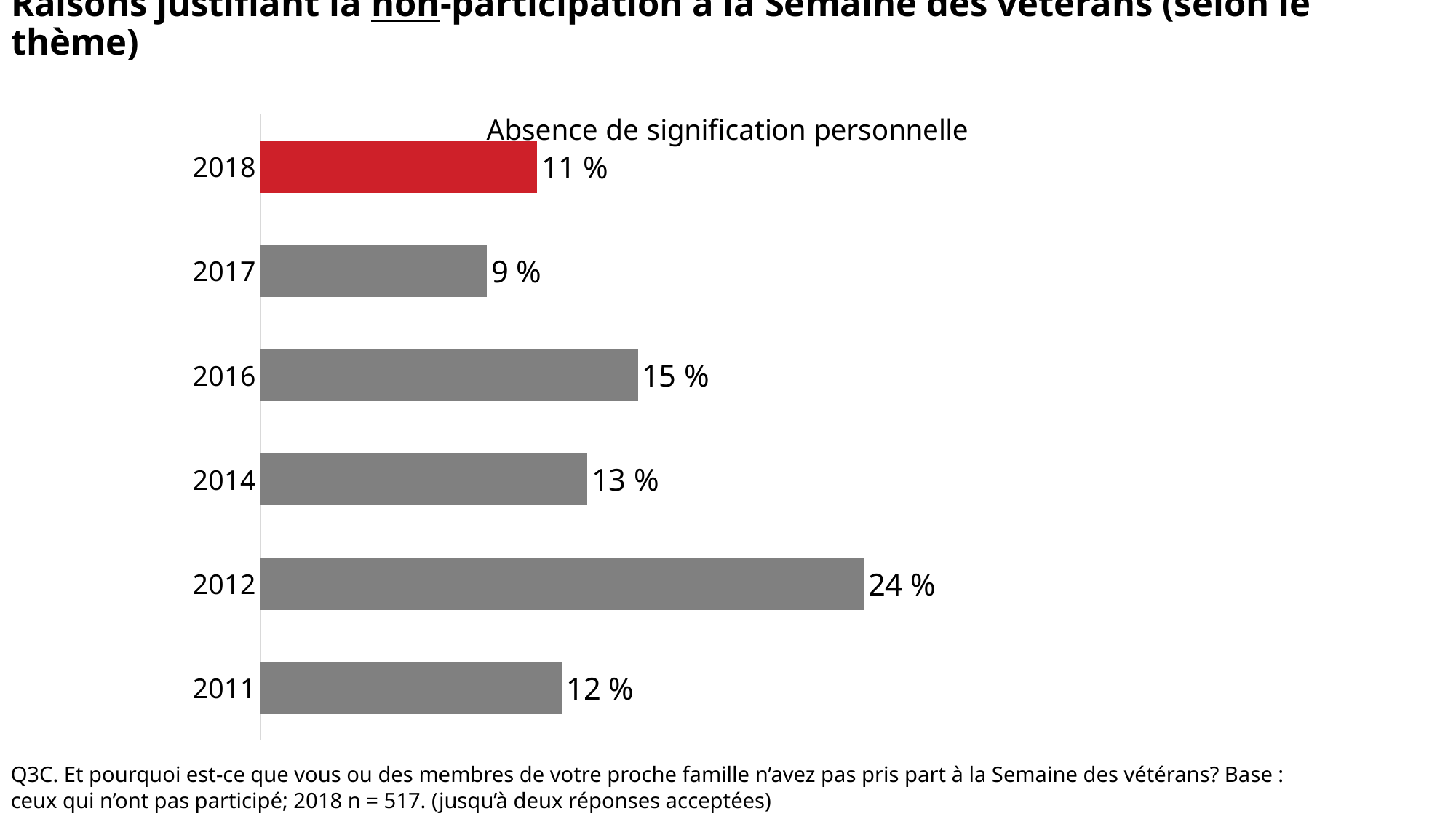
Which year has the lowest value? 2017 What kind of chart is shown on the slide? Bar chart What is the value for 2017? 9 % How many years are shown in the chart? 6 Which year has the highest value? 2012 Which year's bar is coloured red? 2018 What is the value for 2018 in the 'Absence de signification personnelle' chart? 11 % What is the value for 2014? 13 % What is the value for 2012? 24 % Which is larger, the value for 2016 or the value for 2014? 2016 What is the difference between the values for 2012 and 2011? 12 % What is the difference between the values for 2016 and 2018? 4 %